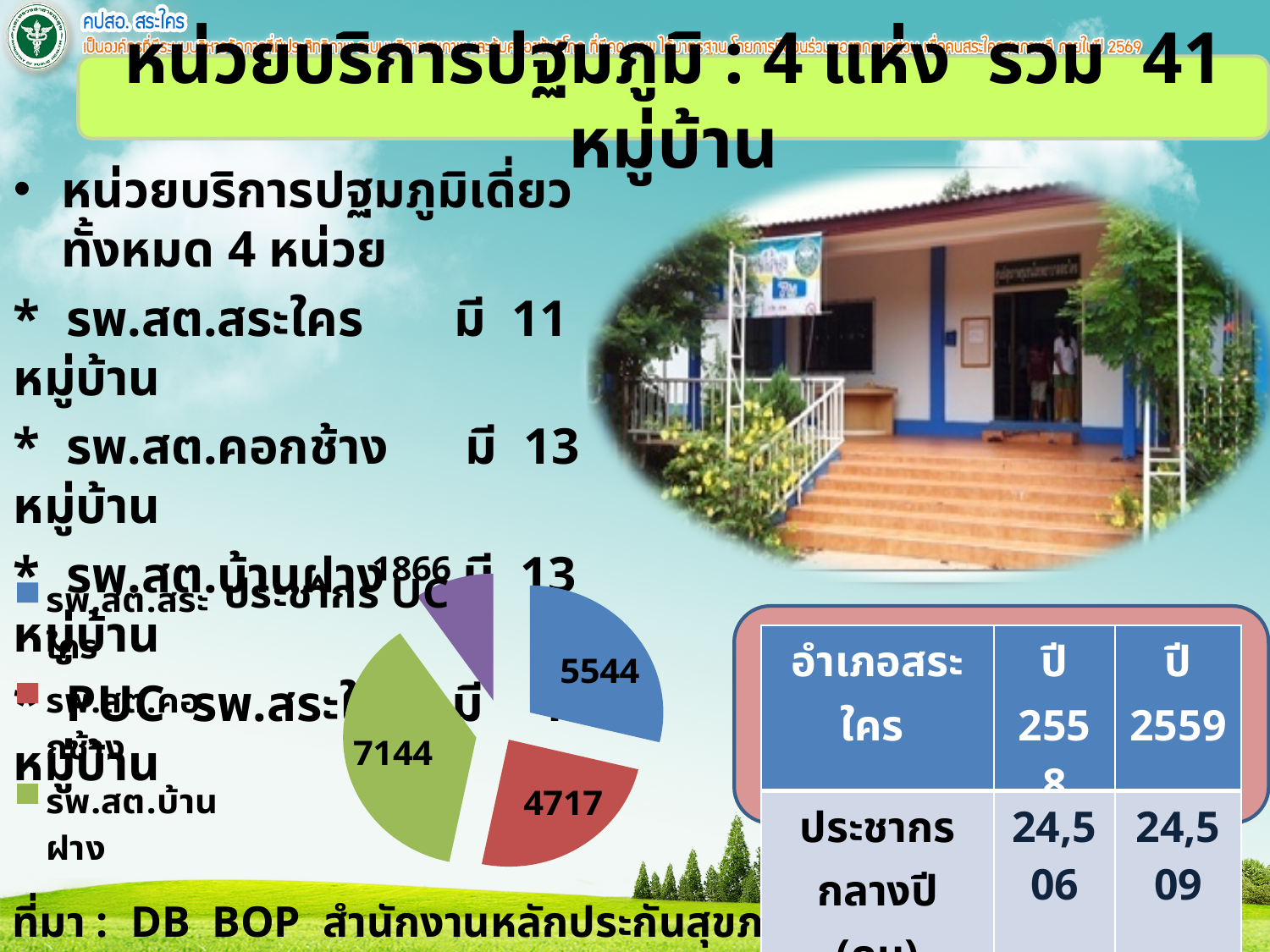
Which category has the largest slice in the pie chart? รพ.สต.บ้านฝาง What is the value of the smallest slice in the pie chart? 1866 In the pie chart, what is the value for รพ.สต.คอกช้าง? 4717 What colour is the slice for รพ.สต.บ้านฝาง in the pie chart? green In the pie chart, what is the value for รพ.สต.บ้านฝาง? 7144 In the pie chart, what is the difference between the values for รพ.สต.บ้านฝาง and รพ.สต.สระใคร? 1600 How many slices does the pie chart have? 4 In the pie chart, which is larger: รพ.สต.สระใคร or รพ.สต.คอกช้าง? รพ.สต.สระใคร In the pie chart, what is the difference between the values for รพ.สต.บ้านฝาง and รพ.สต.คอกช้าง? 2427 What type of chart is shown on the slide? pie chart In the pie chart, what is the value for รพ.สต.สระใคร? 5544 In the pie chart, what is the difference between the values for รพ.สต.สระใคร and รพ.สต.คอกช้าง? 827